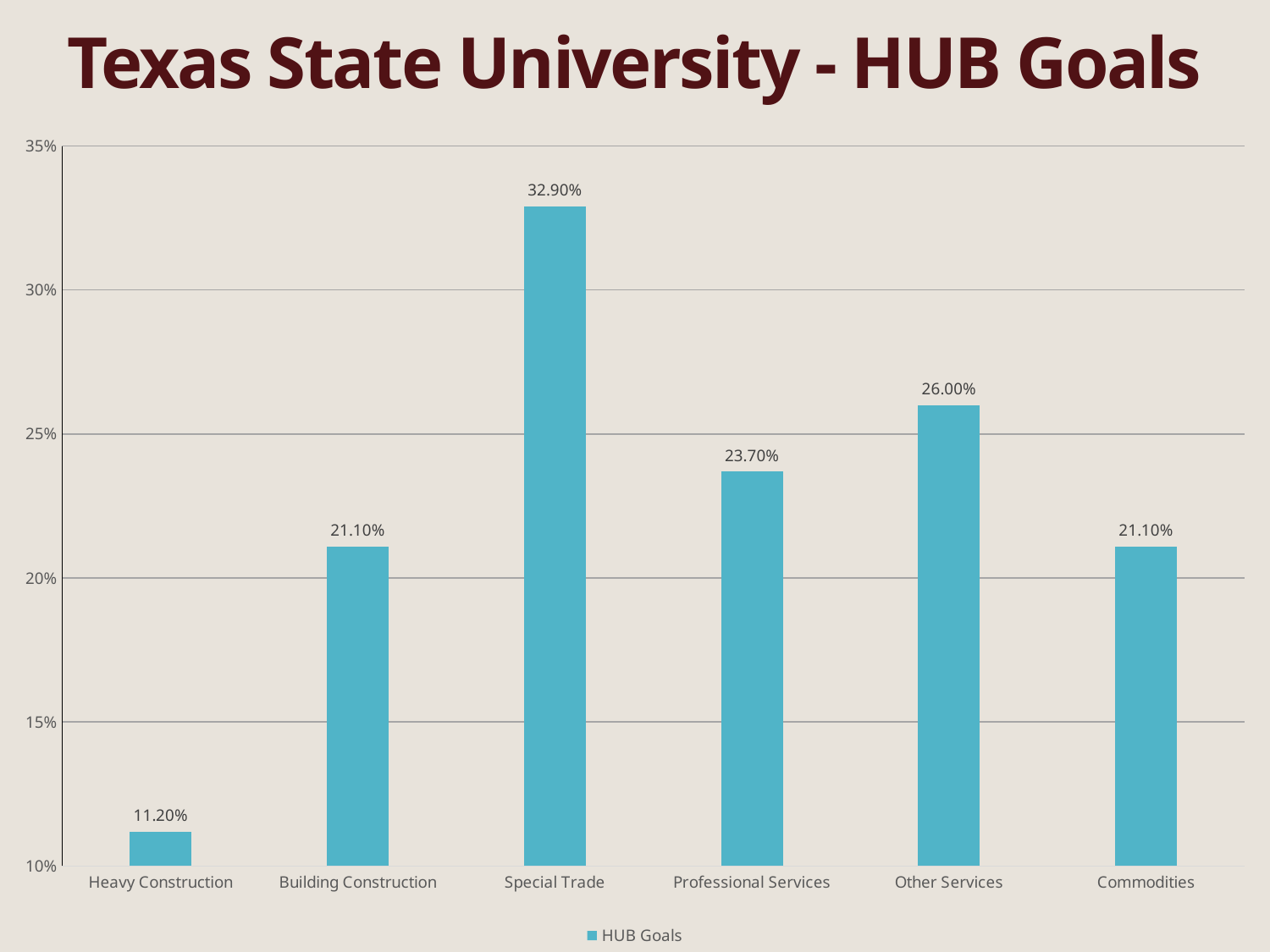
What is the title of the chart? Texas State University - HUB Goals How many series does the legend list? 1 What is the HUB goal for Special Trade? 32.90% Which has a higher HUB goal, Other Services or Professional Services? Other Services How many categories are shown on the chart? 6 What is the HUB goal for Heavy Construction? 11.20% What is the HUB goal for Other Services? 26.00% What is the difference between the HUB goals for Special Trade and Professional Services? 9.20% Which category has the highest HUB goal? Special Trade Is the HUB goal for Professional Services greater or less than 25%? less What kind of chart is shown on the slide? bar chart Which category has the lowest HUB goal? Heavy Construction